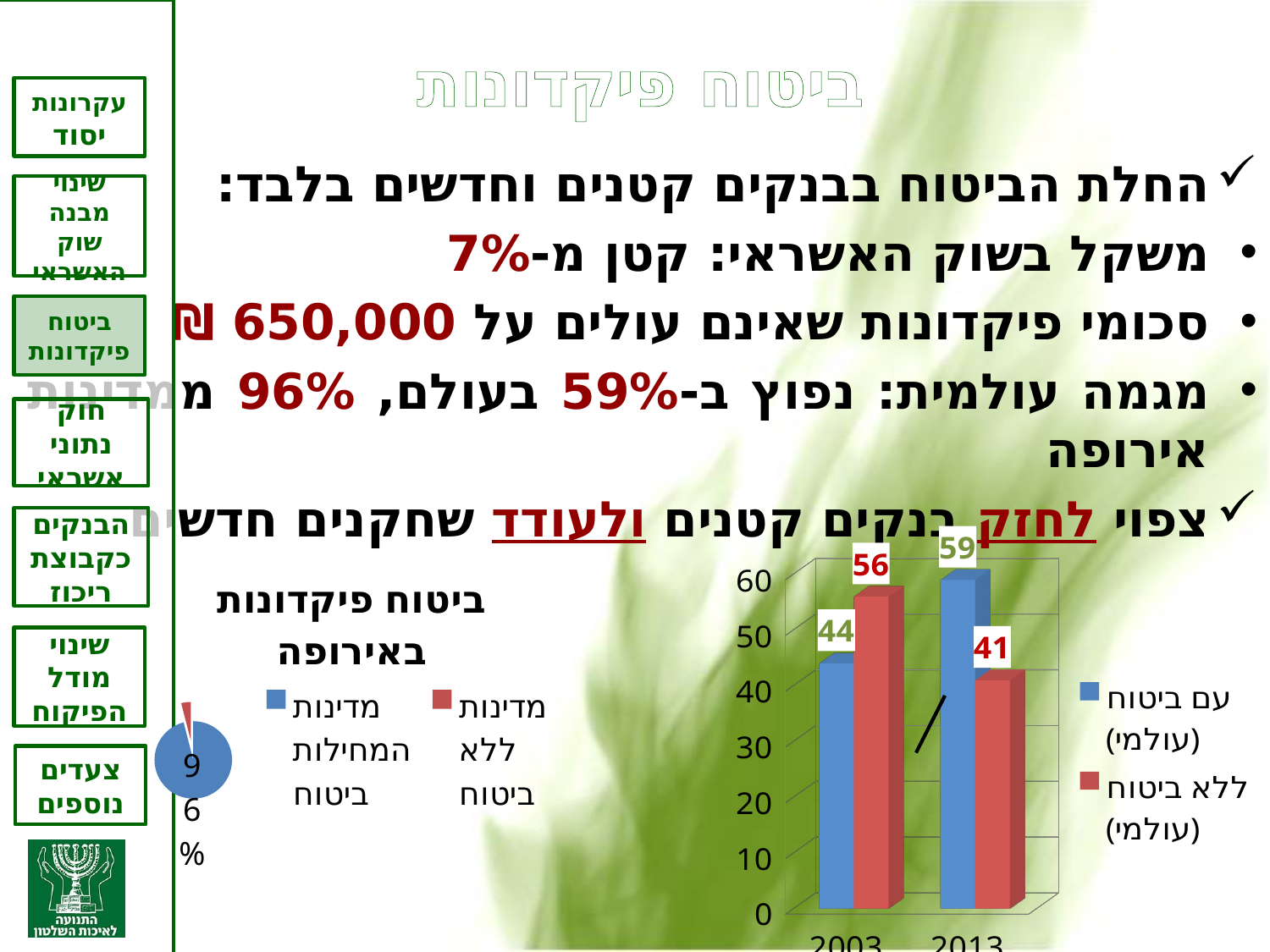
In the bar chart, what is the difference between 'עם ביטוח (עולמי)' in 2013 and in 2003? 15 How many years are shown on the x axis of the bar chart? 2 What kind of chart is the chart with the years 2003 and 2013? bar chart In the bar chart, which is larger in 2013: 'עם ביטוח (עולמי)' or 'ללא ביטוח (עולמי)'? עם ביטוח (עולמי) In the pie chart titled 'ביטוח פיקדונות באירופה', what share is shown for the large blue slice? 96% In the bar chart, what is the value for 'ללא ביטוח (עולמי)' in 2003? 56 How many series does the legend of the bar chart list? 2 In the bar chart, what is the value for 'עם ביטוח (עולמי)' in 2013? 59 In the bar chart, what is the value for 'עם ביטוח (עולמי)' in 2003? 44 In the bar chart, which year has the higher value for 'עם ביטוח (עולמי)'? 2013 In the bar chart, what is the value for 'ללא ביטוח (עולמי)' in 2013? 41 In the bar chart, does the value for 'ללא ביטוח (עולמי)' rise or fall from 2003 to 2013? fall